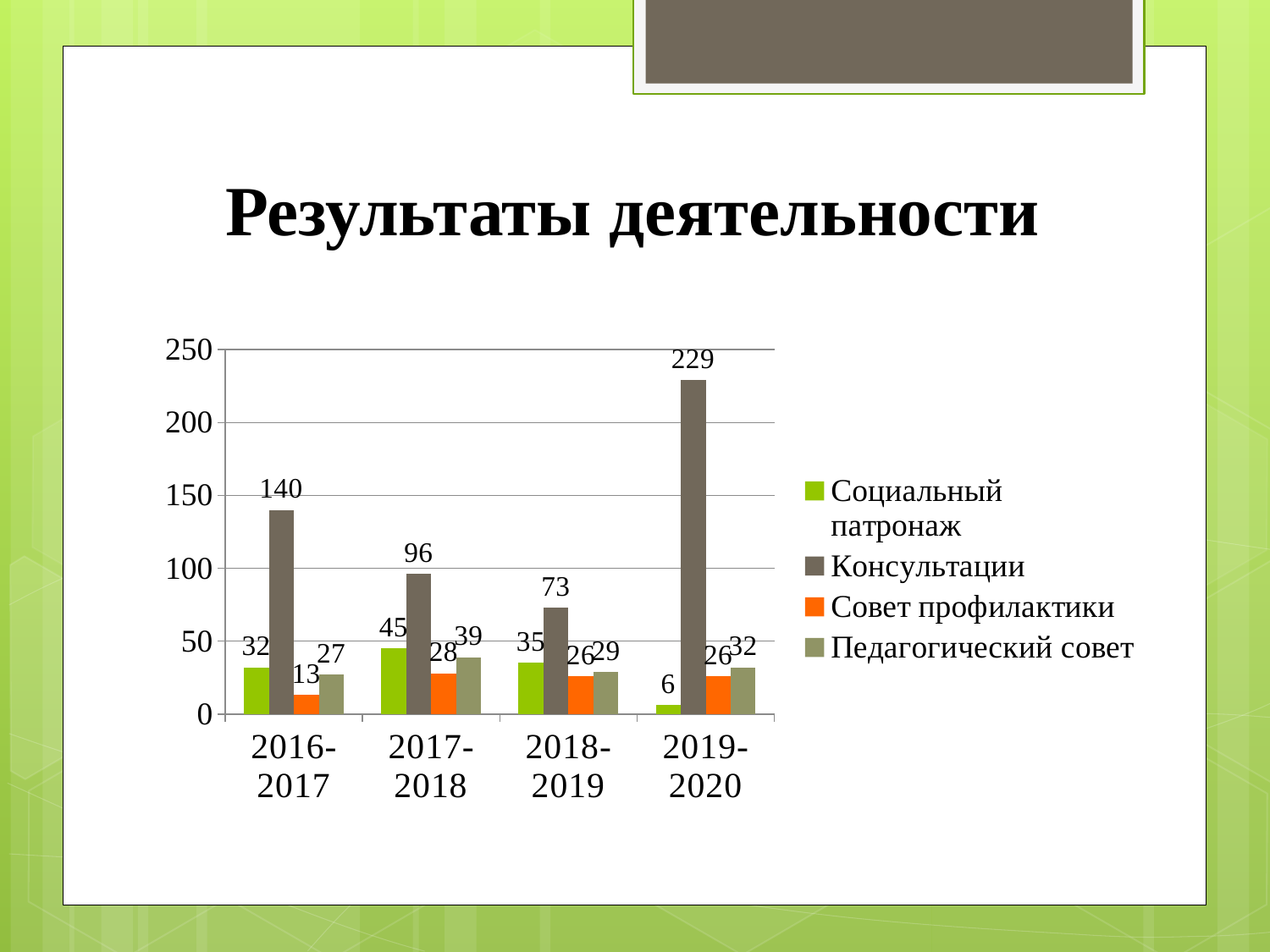
How many series does the legend list? 4 What is the title of the slide? Результаты деятельности In which period is the value for Консультации highest? 2019-2020 Which is larger: Педагогический совет in 2017-2018 or Педагогический совет in 2019-2020? Педагогический совет in 2017-2018 What is the value for Совет профилактики in 2016-2017? 13 How many periods are shown on the x axis? 4 What is the value for Социальный патронаж in 2017-2018? 45 What is the value for Педагогический совет in 2018-2019? 29 In which period is the value for Социальный патронаж lowest? 2019-2020 What is the value for Консультации in 2019-2020? 229 What is the difference between the Консультации values for 2019-2020 and 2016-2017? 89 What kind of chart is shown on the slide? Bar chart